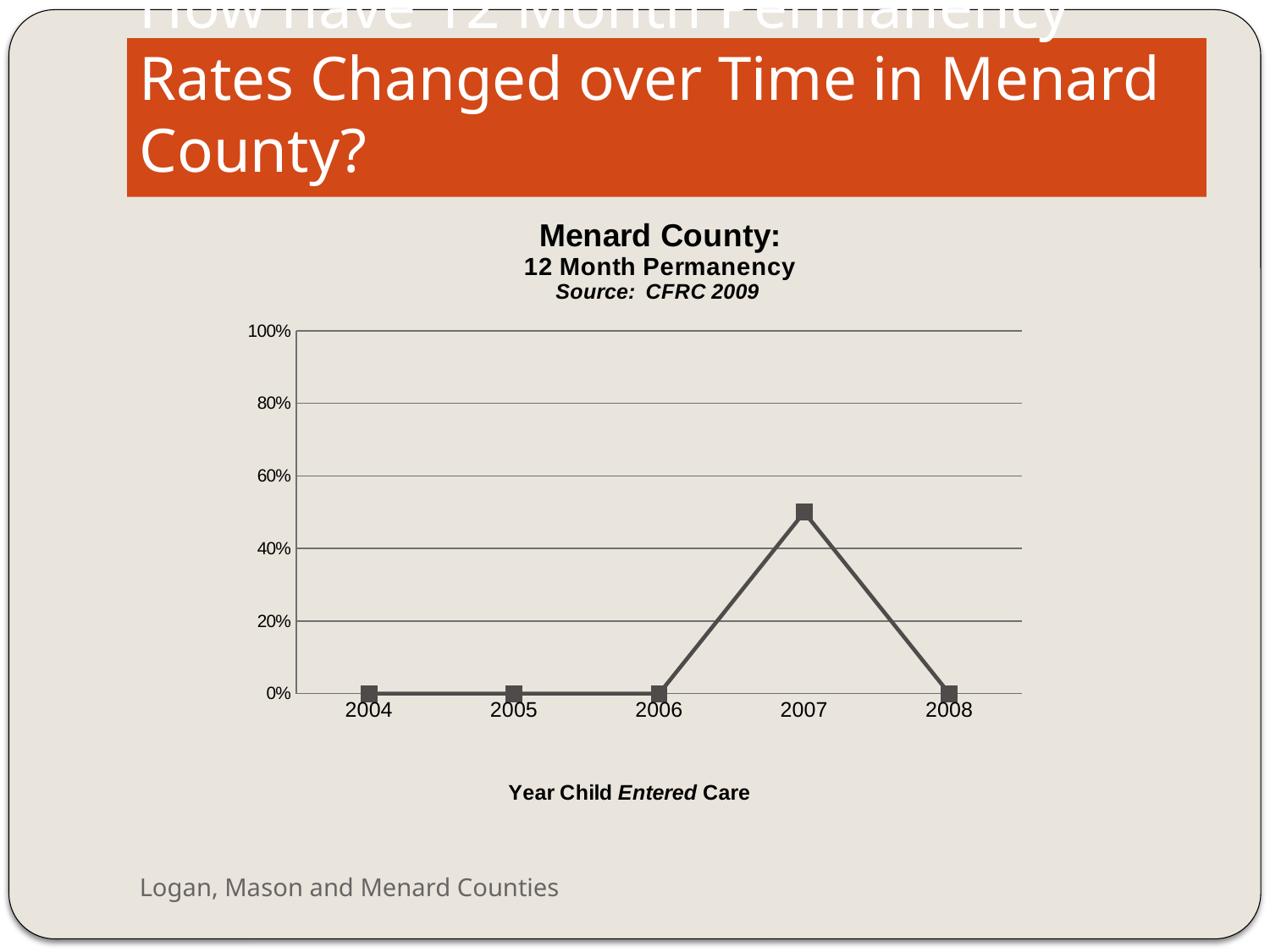
What kind of chart is shown on the slide? line chart What is the 12 month permanency rate for 2004? 0% Is the value for 2007 greater or less than 60%? less Which year has the highest 12 month permanency rate in the chart? 2007 What source is cited in the chart title? CFRC 2009 What is the 12 month permanency rate for 2008? 0% Which is larger, the value for 2007 or the value for 2005? 2007 Does the value rise or fall from 2006 to 2007? rise Is the value for 2007 greater or less than 40%? greater Does the value rise or fall from 2007 to 2008? fall What is the label of the x axis of the chart? Year Child Entered Care How many years are plotted on the x axis of the chart? 5